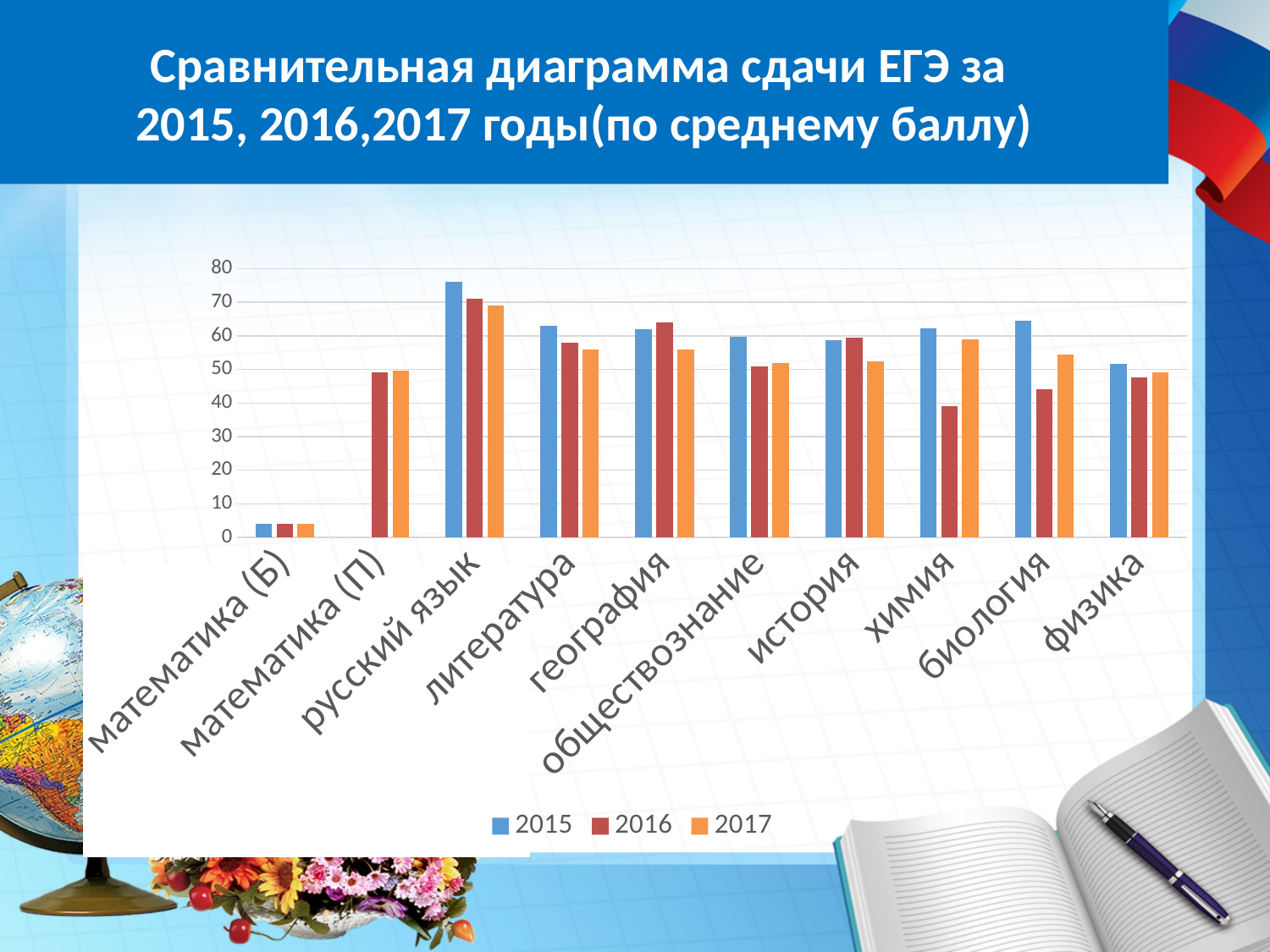
Which subject has the lowest value for 2015? математика (Б) How many series does the legend list? 3 Is the 2016 value for химия greater or less than 50? less Which subject has the highest value for 2016? русский язык For география, which year has the larger value, 2016 or 2017? 2016 Which years are listed in the legend? 2015, 2016, 2017 What kind of chart is shown on the slide? bar chart How many subject categories are shown on the x axis? 10 Is the 2016 value for биология greater or less than 50? less Which subject has the highest value for 2015? русский язык Is the 2015 value for русский язык greater or less than 70? greater For химия, which year has the larger value, 2015 or 2016? 2015